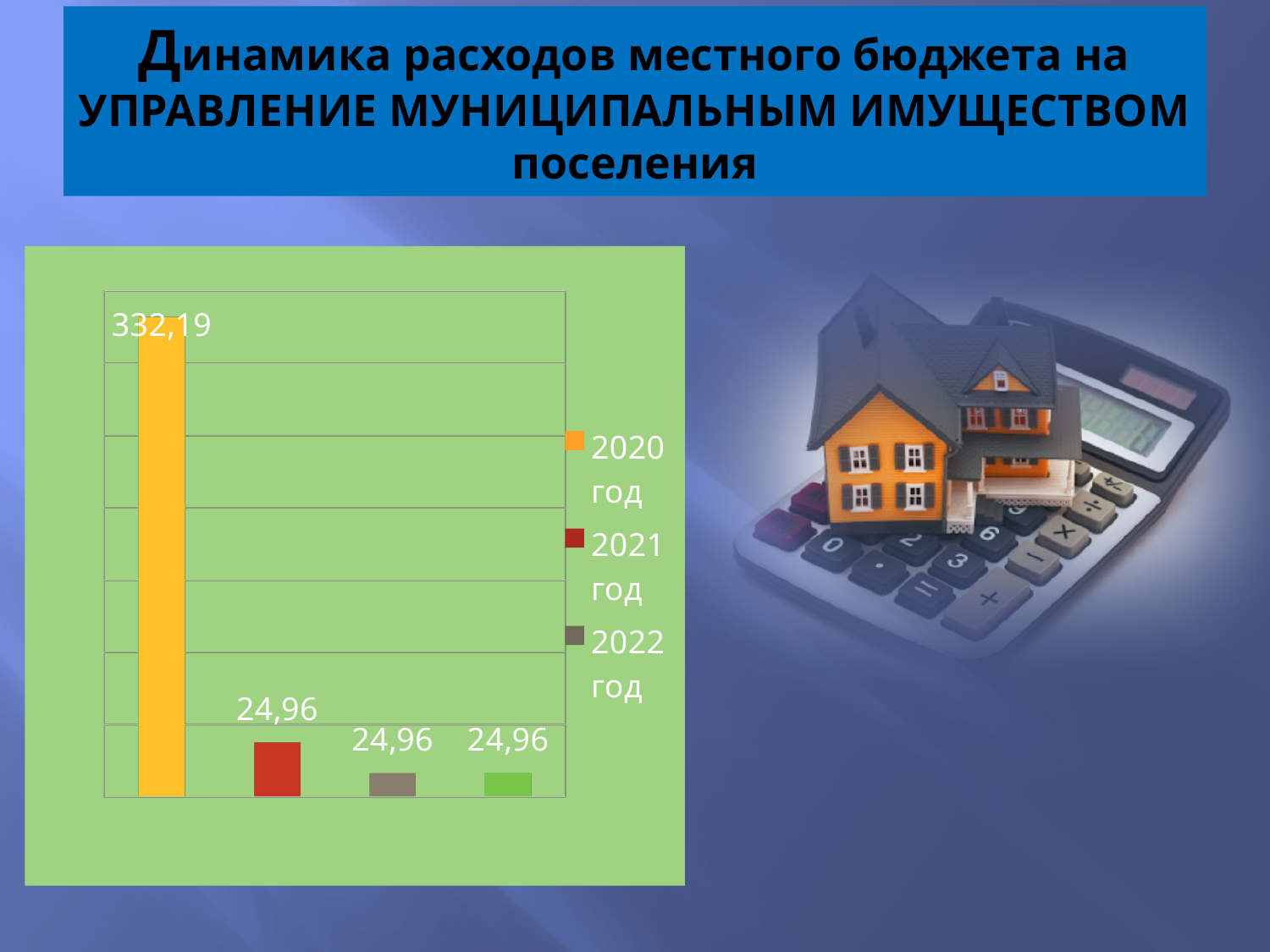
Which is larger, the value for 2020 год or the value for 2022 год? 2020 год How many bars are plotted on the chart? 4 How many entries does the legend list? 3 What is the value shown for 2020 год? 332,19 What is the value shown for 2021 год? 24,96 Does the value rise or fall from 2020 год to 2021 год? fall What kind of chart is shown on the slide? bar chart Which year has the highest value on the chart? 2020 год What is the difference between the values for 2020 год and 2021 год? 307,23 What colour is the bar for 2021 год? red What is the value shown for 2022 год? 24,96 What colour is the bar for 2020 год? orange